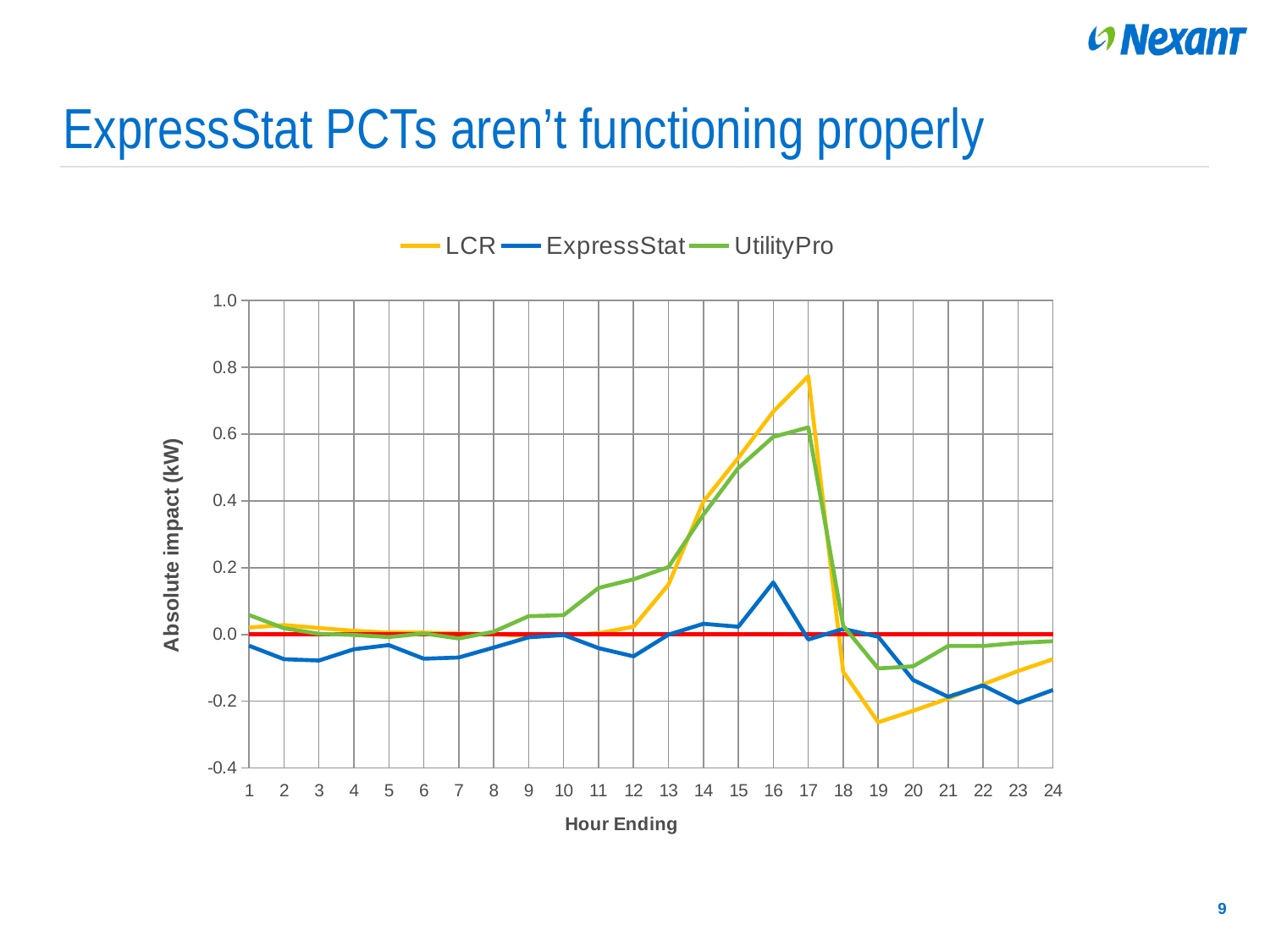
Does the LCR series rise or fall from hour ending 13 to hour ending 17? rise How many hours are plotted along the x axis? 24 What kind of chart is shown on the slide? line chart Is the LCR value at hour ending 19 greater or less than -0.2? less Is the ExpressStat value at hour ending 16 greater or less than 0.2? less At which hour ending does the LCR series reach its lowest value? 19 What is the label of the y axis? Absolute impact (kW) Is the LCR value at hour ending 17 greater or less than 0.6? greater Which series reaches the highest value at hour ending 17? LCR At hour ending 16, which series has the larger value, LCR or ExpressStat? LCR At which hour ending does the LCR series reach its highest value? 17 How many series does the legend list? 3